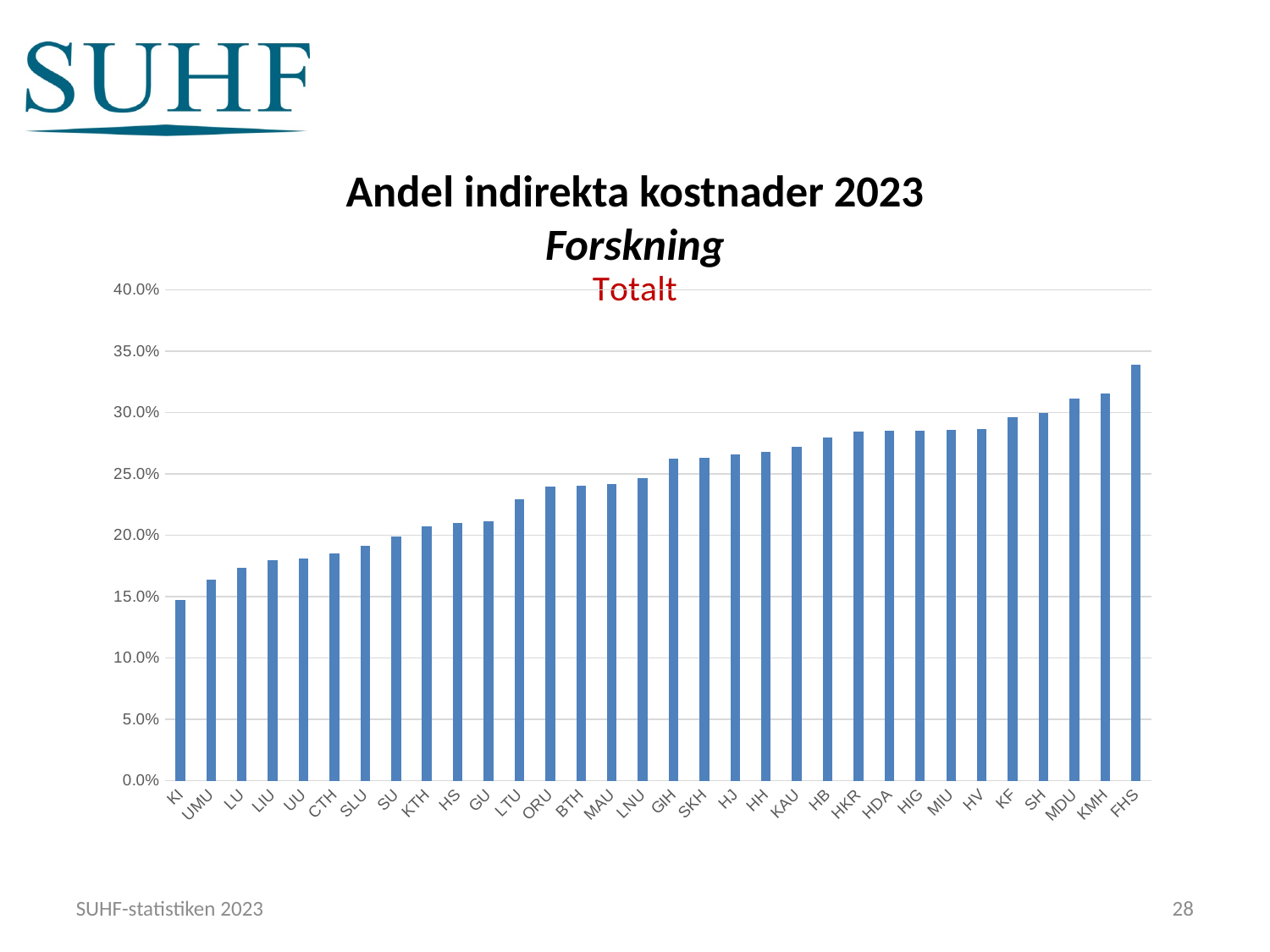
What kind of chart is shown on the slide? bar chart What is the main title of the chart? Andel indirekta kostnader 2023 Is the value for HB greater or less than 25.0%? greater Which has the larger value, LU or LTU? LTU Is the value for SLU greater or less than 20.0%? less Do the values rise or fall moving from left to right along the x axis? rise Which institution has the highest share of indirect costs in the chart? FHS Is the value for FHS greater or less than 30.0%? greater Which institution has the lowest share of indirect costs in the chart? KI How many institutions are shown on the x axis of the chart? 32